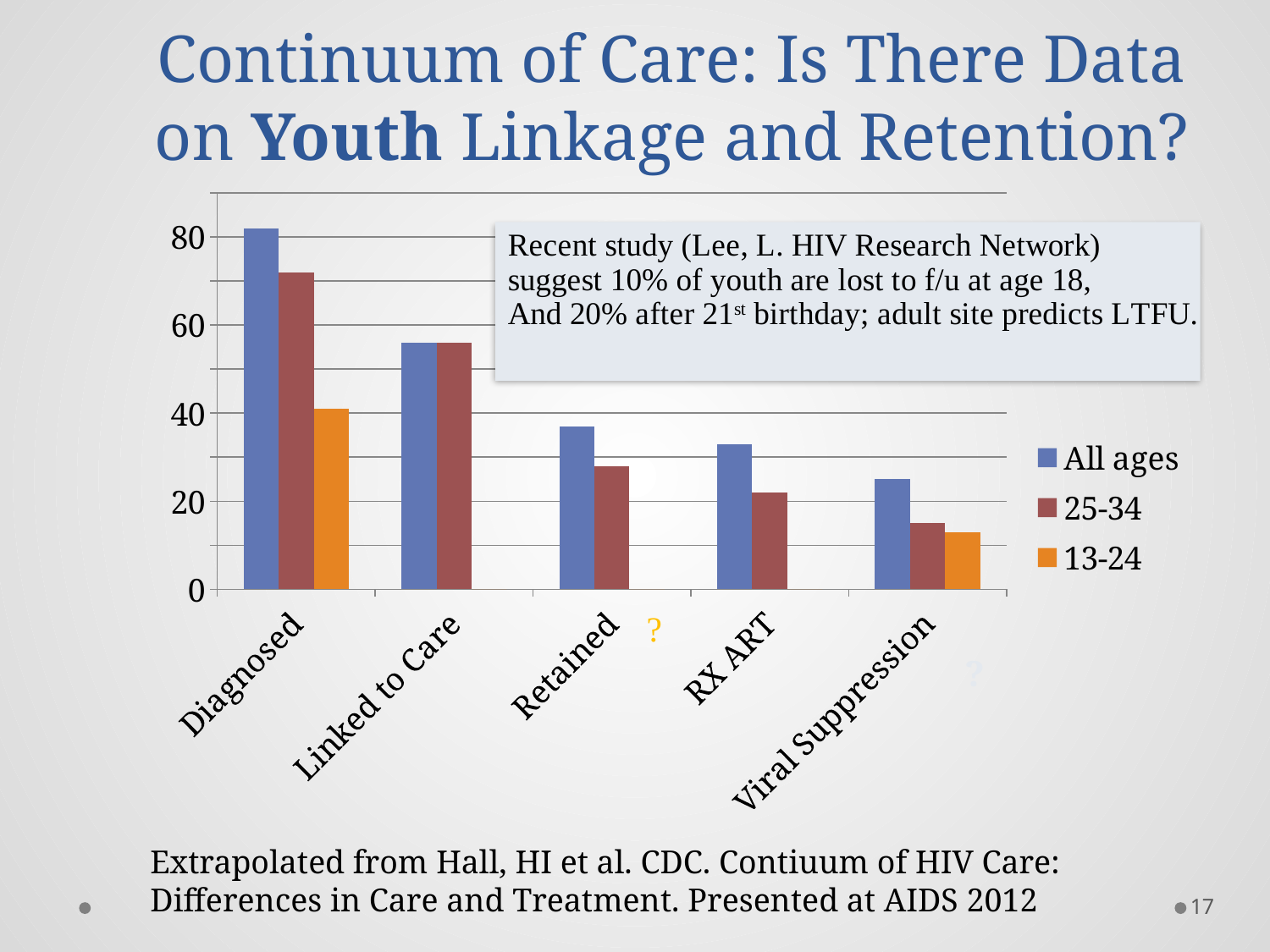
For Diagnosed, which is larger: the All ages value or the 25-34 value? All ages Is the 13-24 value for Viral Suppression greater or less than 20? less Is the All ages value for Retained greater or less than 40? less For Retained, which is larger: the All ages value or the 25-34 value? All ages Which category has the highest value for the All ages series? Diagnosed Which series is shown in orange in the chart's legend? 13-24 Which category has the lowest value for the All ages series? Viral Suppression How many categories are shown along the x axis of the chart? 5 What kind of chart is shown on the slide? bar chart Do the All ages values rise or fall moving from Diagnosed to Viral Suppression along the x axis? fall Is the All ages value for Linked to Care greater or less than 60? less How many series does the chart's legend list? 3